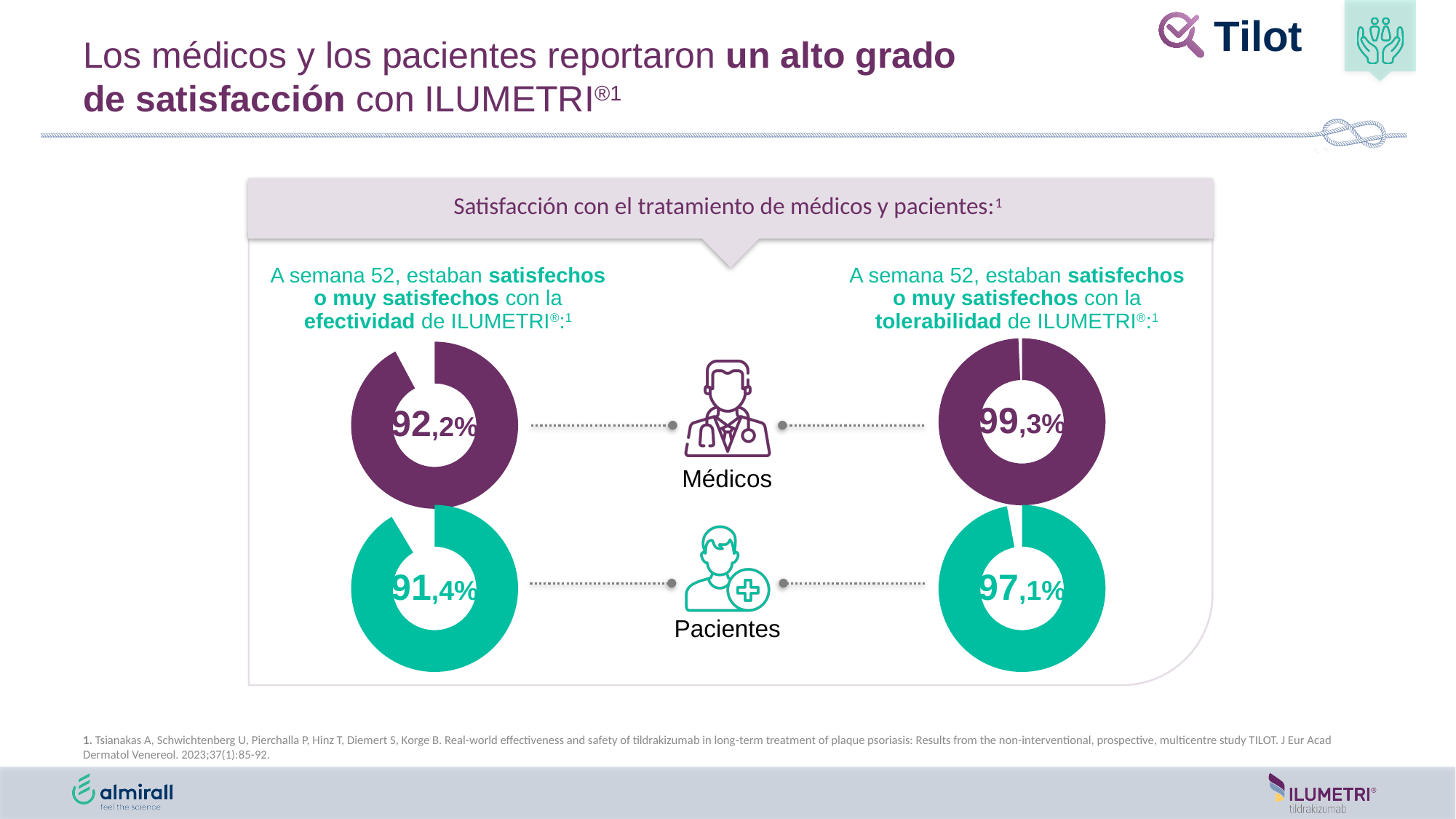
What percentage of pacientes were satisfied or very satisfied with the tolerabilidad of ILUMETRI at week 52? 97,1% For efectividad, who reported a higher satisfaction percentage, médicos or pacientes? Médicos What is the difference between the pacientes' satisfaction with tolerabilidad and their satisfaction with efectividad? 5,7 percentage points What percentage of médicos were satisfied or very satisfied with the tolerabilidad of ILUMETRI at week 52? 99,3% What kind of chart is used to display the satisfaction percentages? Donut (pie) chart How many donut charts are shown on the slide? 4 For tolerabilidad, who reported a higher satisfaction percentage, médicos or pacientes? Médicos Which of the four donut charts shows the lowest satisfaction percentage? Pacientes, efectividad (91,4%) Which of the four donut charts shows the highest satisfaction percentage? Médicos, tolerabilidad (99,3%) What percentage of pacientes were satisfied or very satisfied with the efectividad of ILUMETRI at week 52? 91,4% What is the difference between the médicos' satisfaction with tolerabilidad and their satisfaction with efectividad? 7,1 percentage points What percentage of médicos were satisfied or very satisfied with the efectividad of ILUMETRI at week 52? 92,2%